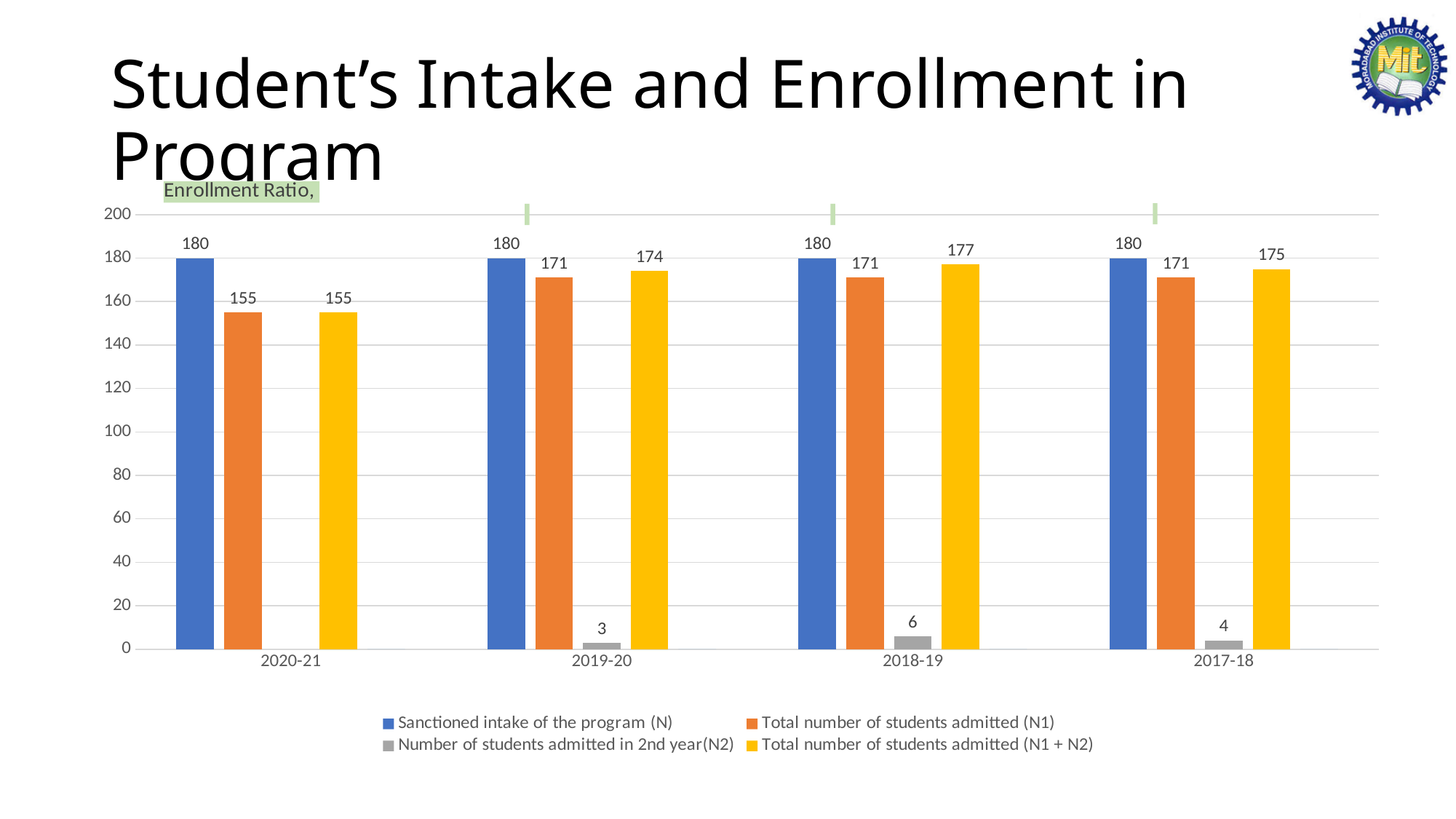
Which is larger: the Number of students admitted in 2nd year (N2) in 2019-20 or in 2017-18? 2017-18 How many academic years are shown on the x axis? 4 What is the Sanctioned intake of the program (N) for 2019-20? 180 Which year has the lowest Total number of students admitted (N1)? 2020-21 What kind of chart is shown on the slide? bar chart How many series does the legend list? 4 What is the difference between the Sanctioned intake (N) and the Total number of students admitted (N1) in 2020-21? 25 Which series is shown in yellow in the legend? Total number of students admitted (N1 + N2) What is the Total number of students admitted (N1) for 2020-21? 155 Which year has the highest Total number of students admitted (N1 + N2)? 2018-19 What is the Total number of students admitted (N1 + N2) for 2017-18? 175 What is the Number of students admitted in 2nd year (N2) for 2018-19? 6